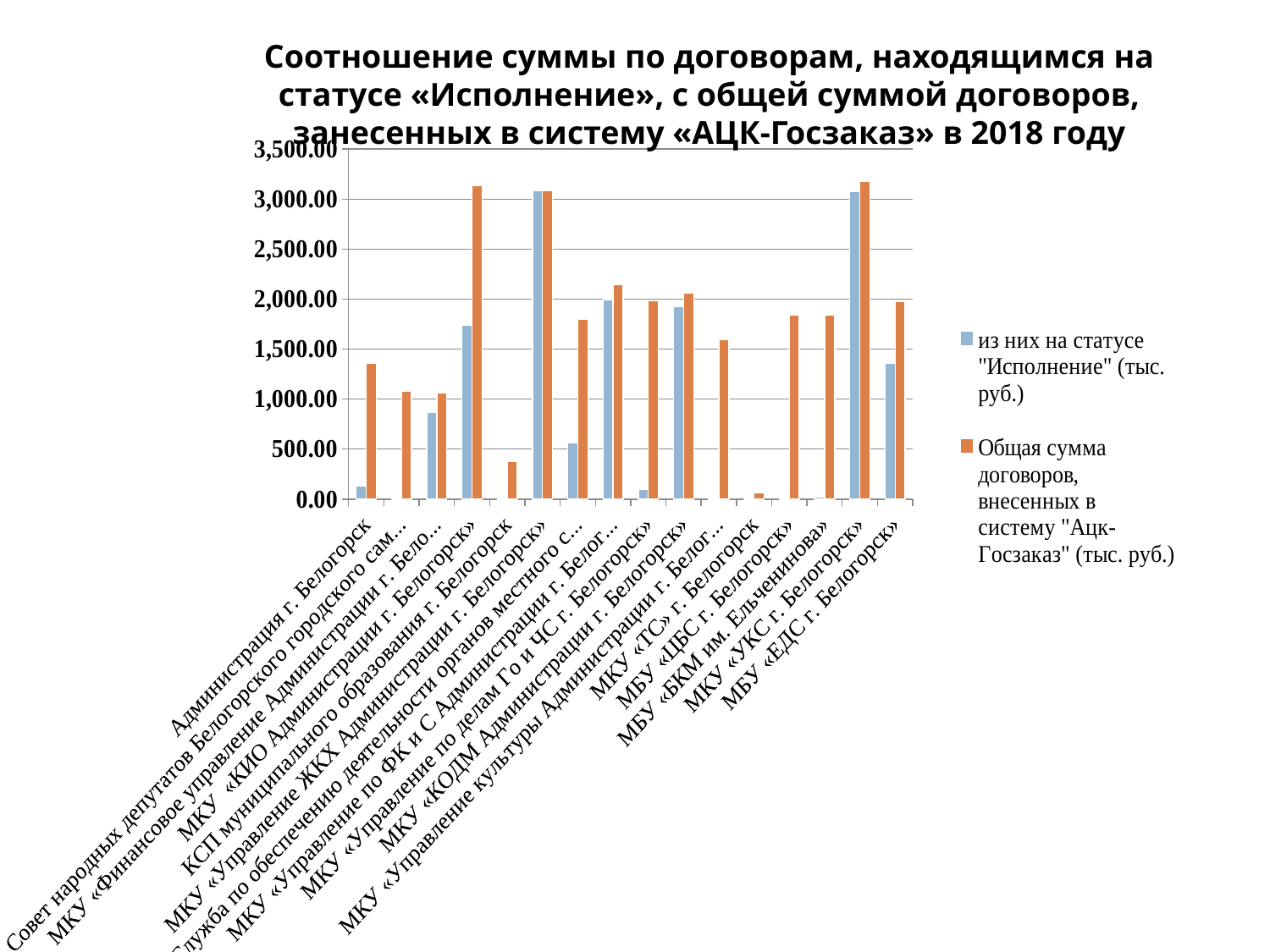
Which colour represents the series "из них на статусе "Исполнение" (тыс. руб.)"? blue Is the value of "Общая сумма договоров, внесенных в систему "Ацк-Госзаказ" (тыс. руб.)" for МБУ «ЕДС г. Белогорск» greater or less than 1,500.00? greater What kind of chart is shown on the slide? bar chart Which category has the lowest value for the series "Общая сумма договоров, внесенных в систему "Ацк-Госзаказ" (тыс. руб.)"? МКУ «ТС» г. Белогорск How many series does the legend list? 2 Is the value of "Общая сумма договоров, внесенных в систему "Ацк-Госзаказ" (тыс. руб.)" for МКУ «Управление ЖКХ Администрации г. Белогорск» greater or less than 3,000.00? greater For МКУ «Управление по ФК и С Администрации г. Белогорск», which series has the larger value? Общая сумма договоров, внесенных в систему "Ацк-Госзаказ" (тыс. руб.) Is the value of "Общая сумма договоров, внесенных в систему "Ацк-Госзаказ" (тыс. руб.)" for Администрация г. Белогорск greater or less than 1,500.00? less Which year does the chart title refer to? 2018 How many categories are shown on the x axis? 16